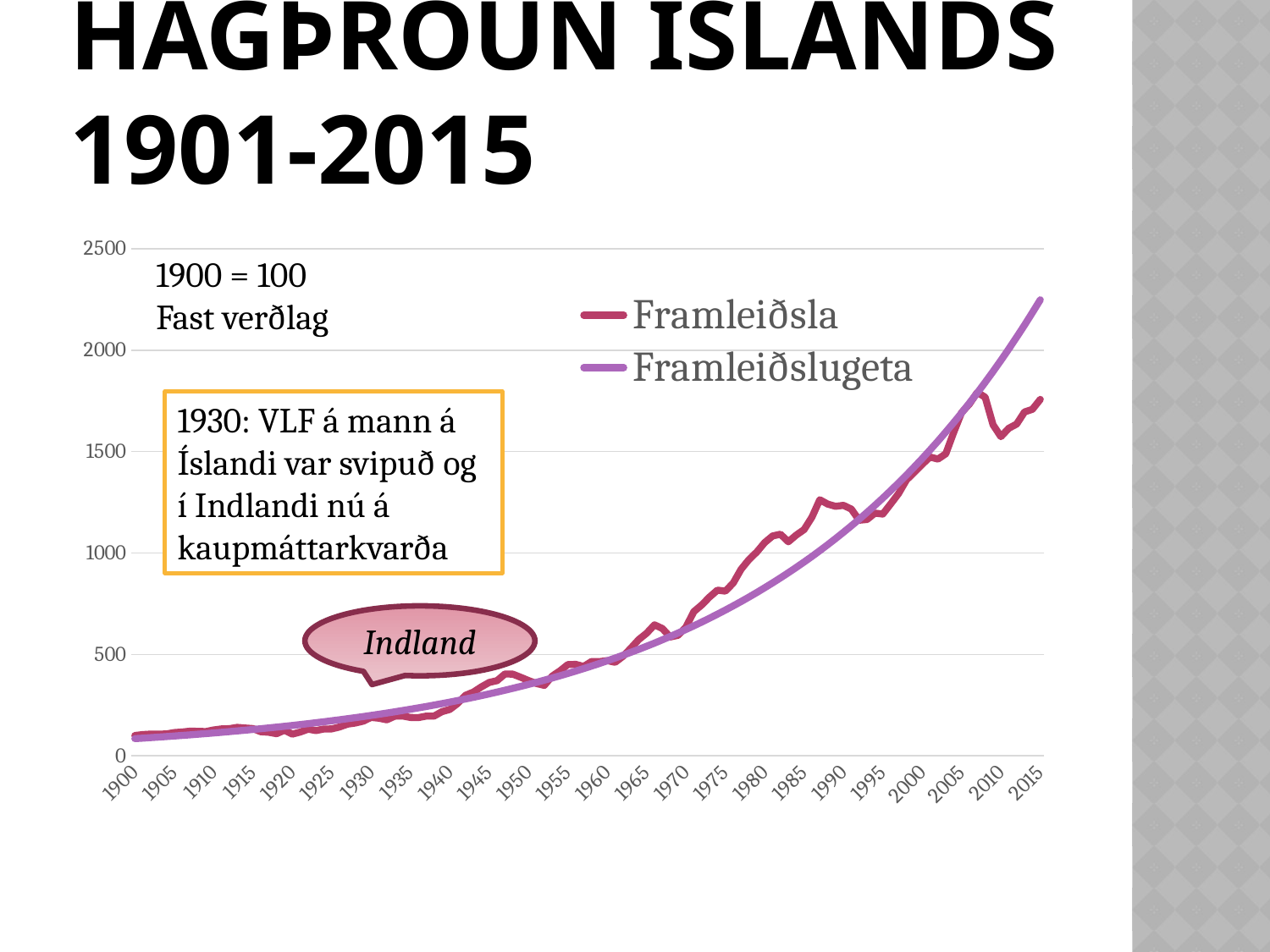
Is the value of Framleiðsla in 2015 greater or less than 2000? less How many year labels are shown on the x axis? 24 In 2015, which series has the higher value, Framleiðsla or Framleiðslugeta? Framleiðslugeta What are the two series named in the chart legend? Framleiðsla and Framleiðslugeta Which series is drawn in purple? Framleiðslugeta Is the value of Framleiðsla in 1940 greater or less than 500? less Is the value of Framleiðslugeta in 2015 greater or less than 2000? greater In 1985, which series has the higher value, Framleiðsla or Framleiðslugeta? Framleiðsla Do the values of Framleiðslugeta rise or fall from 1900 to 2015? rise What kind of chart is shown on the slide? line chart How many series does the chart legend list? 2